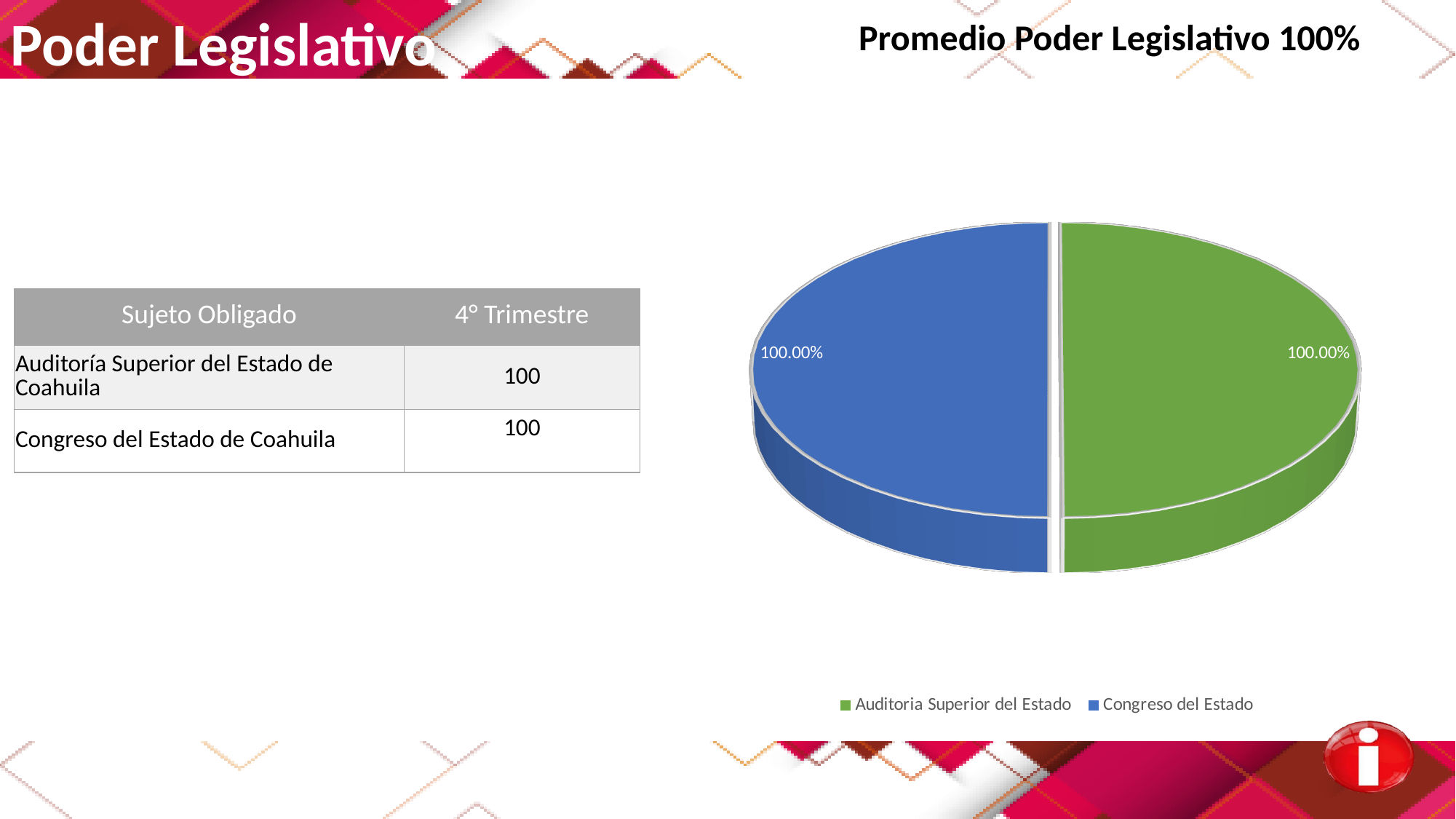
What kind of chart is shown on the slide? pie chart What is the title shown above the pie chart? Promedio Poder Legislativo 100% Which colour represents Congreso del Estado in the pie chart? blue How many entries does the pie chart's legend list? 2 How many slices does the pie chart have? 2 Which legend entry is shown in green in the pie chart? Auditoria Superior del Estado What data label is shown on the Congreso del Estado slice of the pie chart? 100.00% What data label is shown on the Auditoria Superior del Estado slice of the pie chart? 100.00% What is the difference between the data labels of the Auditoria Superior del Estado slice and the Congreso del Estado slice? 0.00%